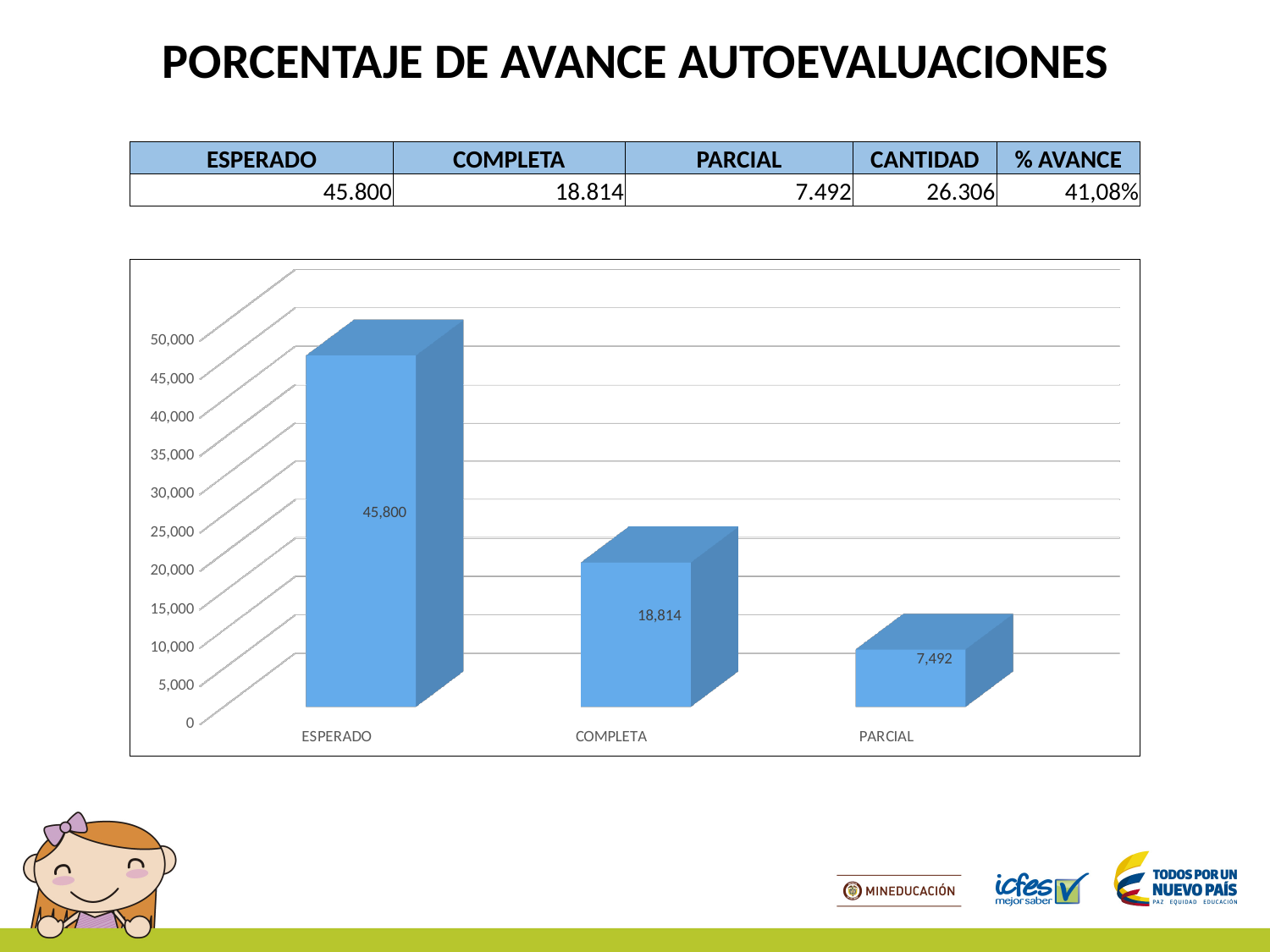
Which category has the lowest bar? PARCIAL How many bars are shown in the chart? 3 What is the difference between the ESPERADO and COMPLETA bars? 26,986 What is the value of the COMPLETA bar? 18,814 Which category has the highest bar? ESPERADO What kind of chart is shown on the slide? bar chart Do the bar values rise or fall from left to right along the x axis? fall Which is larger, the COMPLETA bar or the PARCIAL bar? COMPLETA What is the value of the PARCIAL bar? 7,492 What is the value of the ESPERADO bar? 45,800 What is the difference between the COMPLETA and PARCIAL bars? 11,322 Is the value for COMPLETA greater or less than 20,000? less